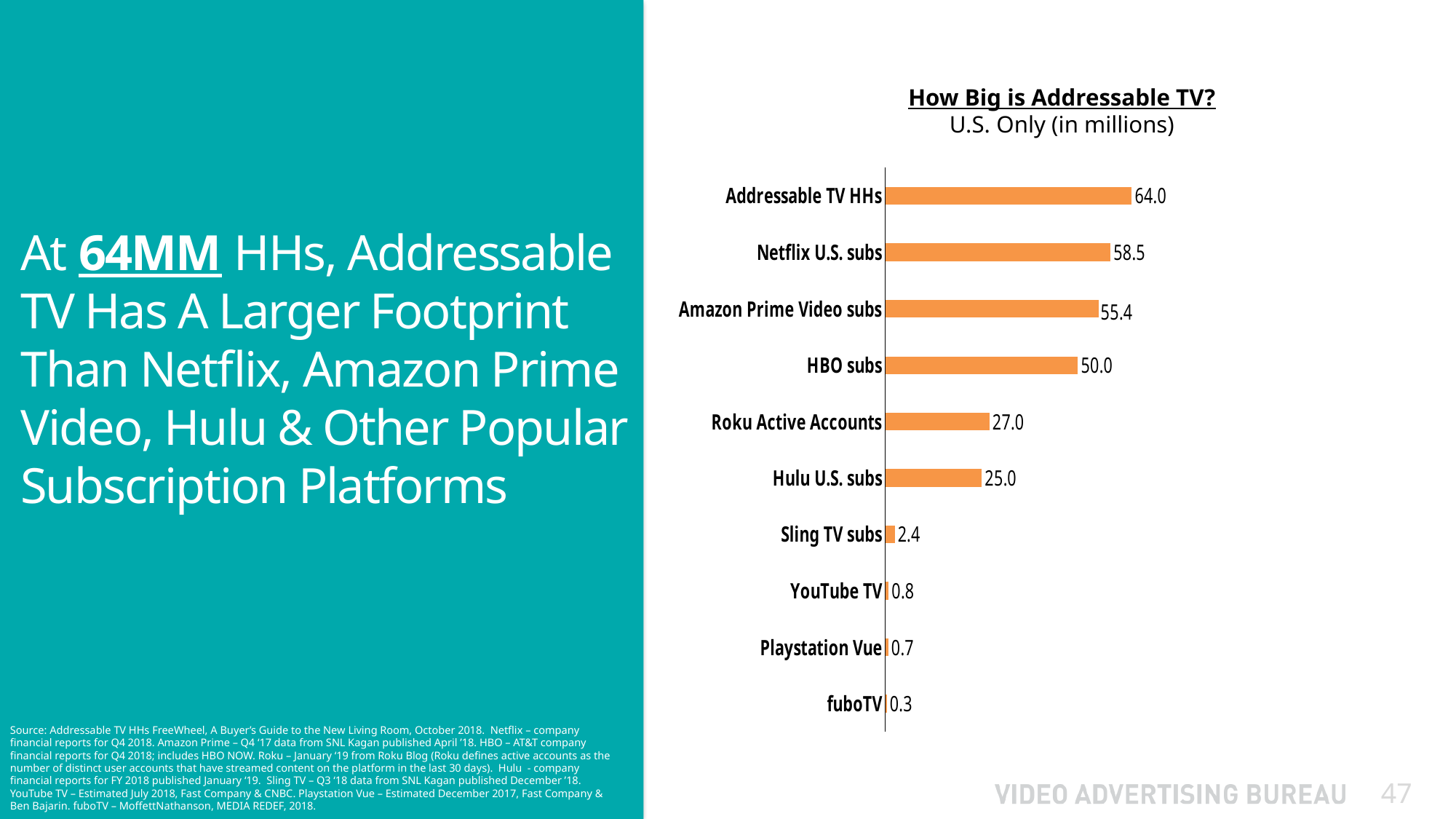
Which category has the lowest value? fuboTV What is the difference between Addressable TV HHs and Netflix U.S. subs? 5.5 What colour are the bars in the chart? Orange What is the title of the chart? How Big is Addressable TV? What kind of chart is this? Bar chart What is the value for Roku Active Accounts? 27.0 How many categories are shown in the chart? 10 What is the value for Sling TV subs? 2.4 Which category has the highest value? Addressable TV HHs What is the value for Netflix U.S. subs? 58.5 Which is larger, Amazon Prime Video subs or HBO subs? Amazon Prime Video subs What is the difference between Roku Active Accounts and Hulu U.S. subs? 2.0